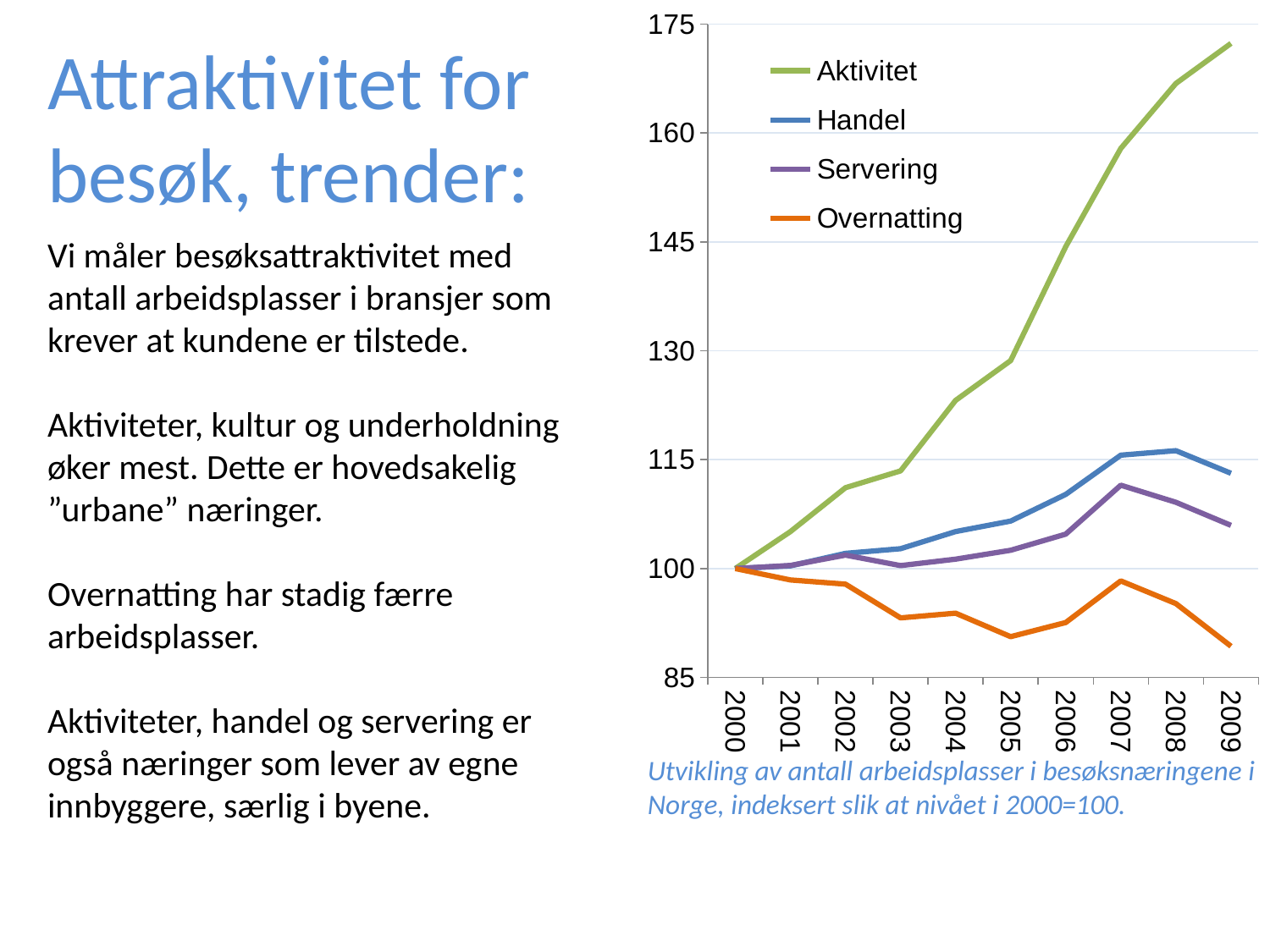
Which is larger in 2009, Handel or Servering? Handel How many series does the legend list? 4 Which series has the lowest value in 2009? Overnatting How many years are shown on the x axis? 10 Is the value for Aktivitet in 2004 greater or less than 115? greater Is the value for Aktivitet in 2009 greater or less than 160? greater What colour is the Overnatting line? orange Which series has the highest value in 2009? Aktivitet What is the value for Aktivitet in 2000? 100 Does the Aktivitet series rise or fall from 2000 to 2009? rise What kind of chart is shown on the slide? line chart Is the value for Overnatting in 2009 greater or less than 100? less